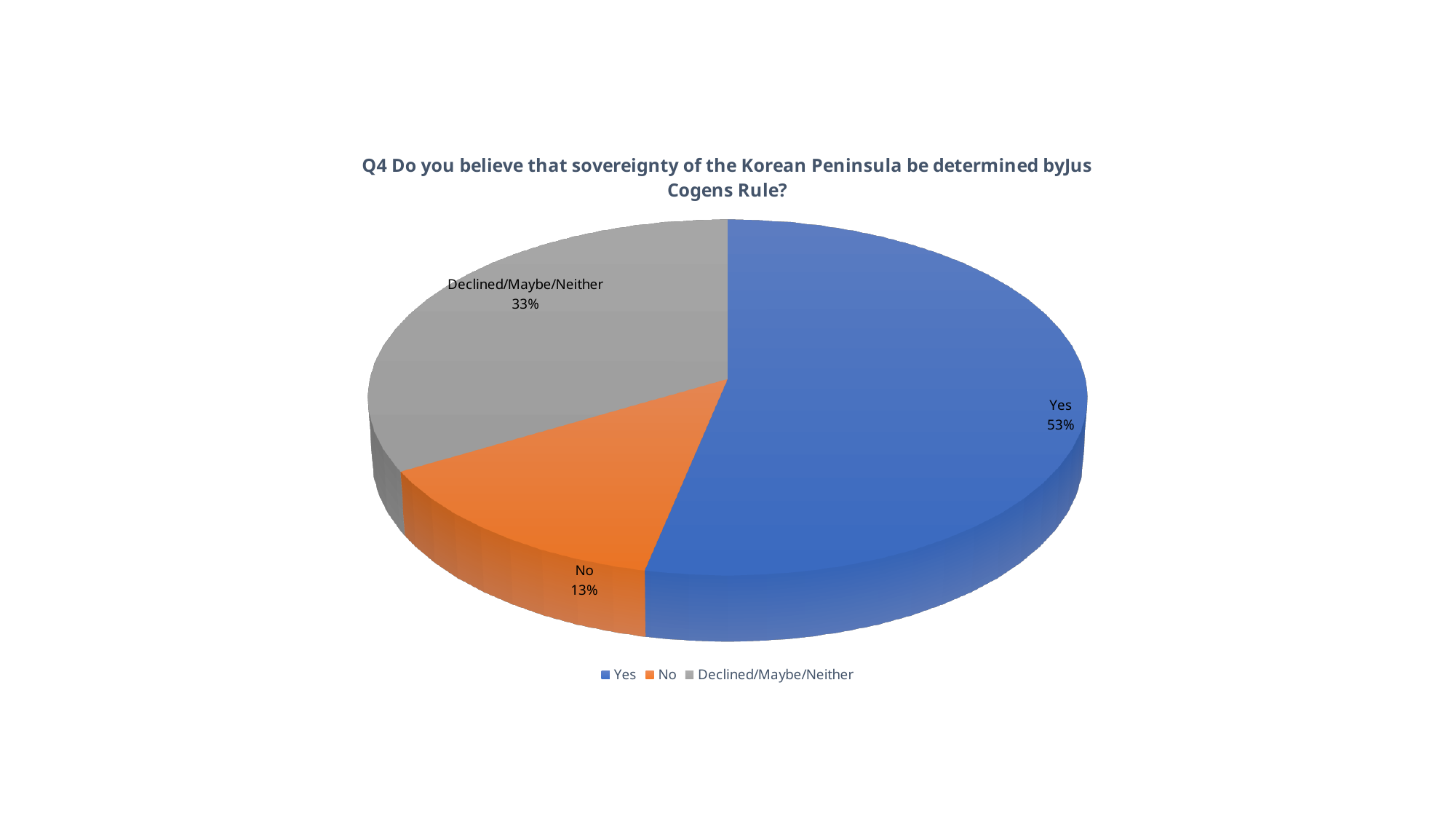
How many slices does the pie chart have? 3 Which is larger, the share for No or the share for Declined/Maybe/Neither? Declined/Maybe/Neither Which response has the smallest share of the pie? No What colour is the Yes slice? Blue What is the difference in percentage points between Yes and Declined/Maybe/Neither? 20 What percentage of respondents answered Yes? 53% How many entries does the legend list? 3 What is the difference in percentage points between Yes and No? 40 What kind of chart is shown on the slide? Pie chart What percentage of respondents answered No? 13% What share of the pie is Declined/Maybe/Neither? 33% Which response has the largest share of the pie? Yes